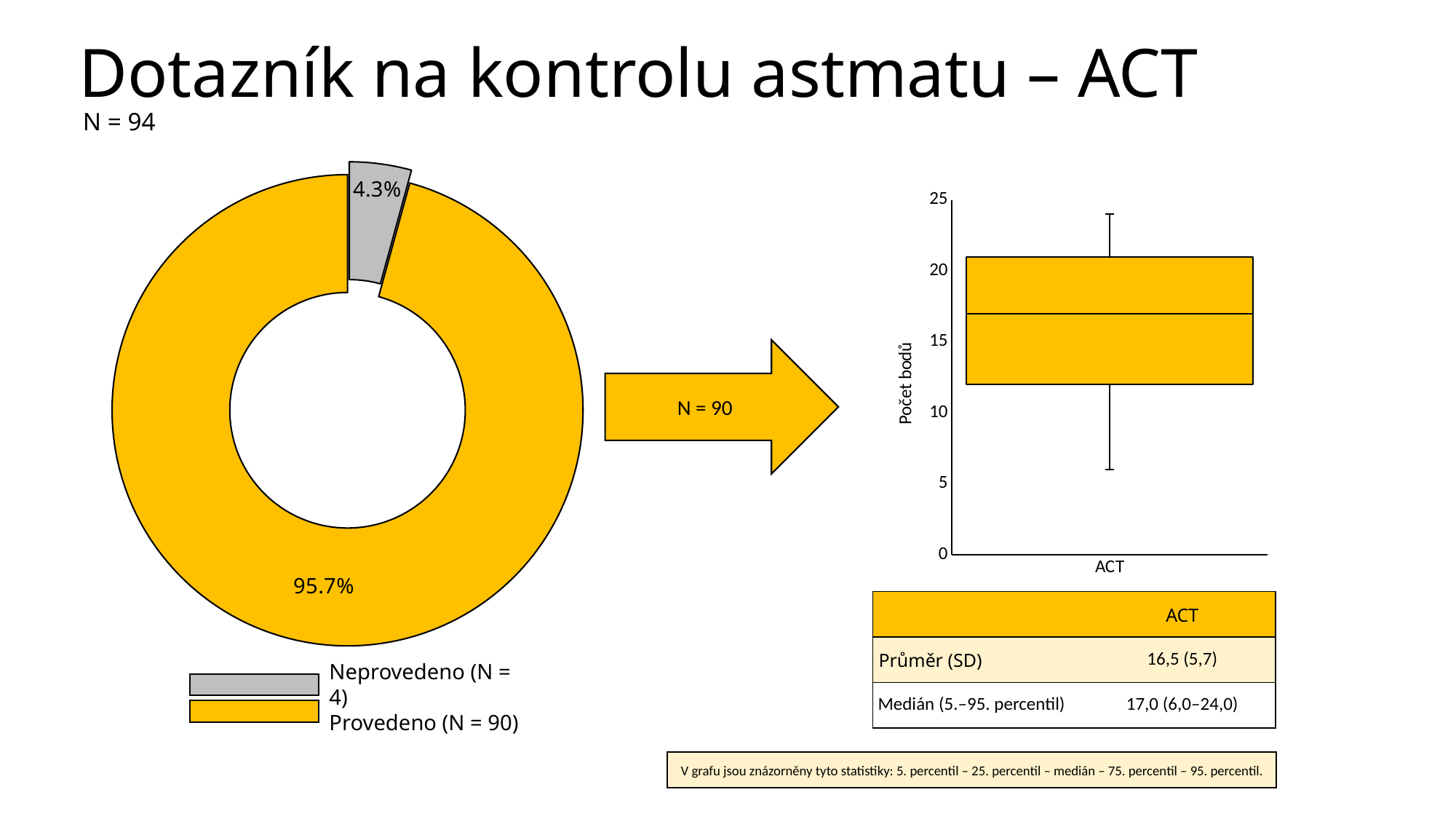
In the donut chart on the left, how many slices are there? 2 In the box plot on the right, is the median for ACT greater or less than 15? greater In the donut chart on the left, which slice is larger, 'Provedeno' or 'Neprovedeno'? Provedeno In the donut chart on the left, what percentage share does the 'Provedeno' slice have? 95.7% In the box plot on the right, what is the label of the y axis? Počet bodů In the donut chart on the left, what percentage share does the 'Neprovedeno' slice have? 4.3% In the donut chart on the left, what N does the legend give for 'Neprovedeno'? 4 In the box plot on the right, how many categories are shown on the x axis? 1 In the donut chart on the left, what is the difference in percentage points between the 'Provedeno' and 'Neprovedeno' shares? 91.4% What kind of chart is shown on the right of the slide? Box plot In the box plot on the right, is the top of the upper whisker for ACT greater or less than 20? greater What kind of chart is shown on the left of the slide? Pie (donut) chart